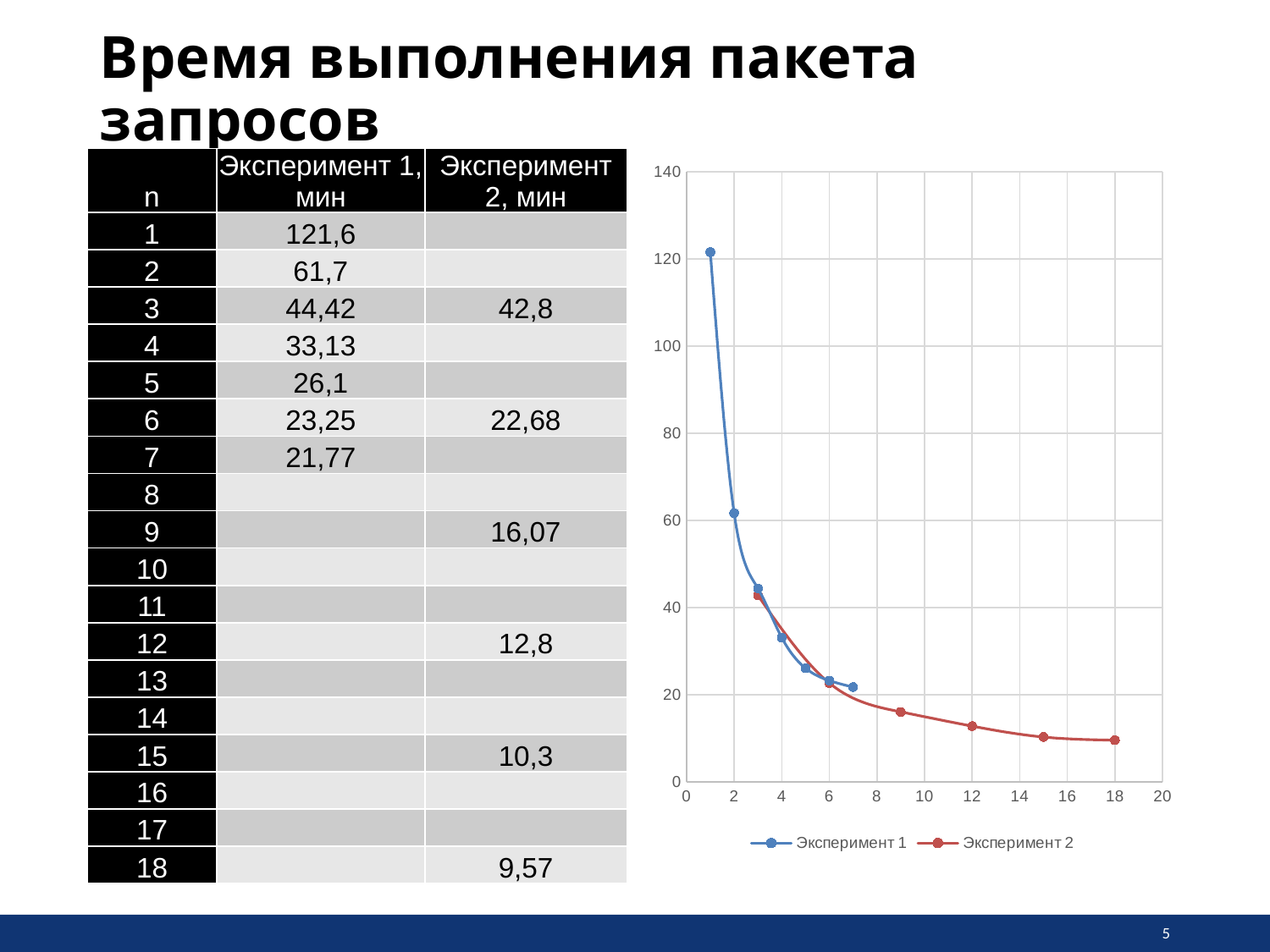
Is the value for Эксперимент 1 at n = 2 greater or less than 80? less How many data points are plotted for Эксперимент 1? 7 How many series does the chart legend list? 2 What is the difference between the Эксперимент 1 values at n = 1 and n = 2? 59,9 What is the value for Эксперимент 1 at n = 1? 121,6 At which n does Эксперимент 2 reach its lowest value? 18 What is the value for Эксперимент 2 at n = 9? 16,07 At n = 3, which series has the larger value, Эксперимент 1 or Эксперимент 2? Эксперимент 1 Do the values for Эксперимент 1 rise or fall as n increases? fall What are the two entries in the chart legend? Эксперимент 1, Эксперимент 2 How many data points are plotted for Эксперимент 2? 6 What kind of chart is shown on the slide? line chart